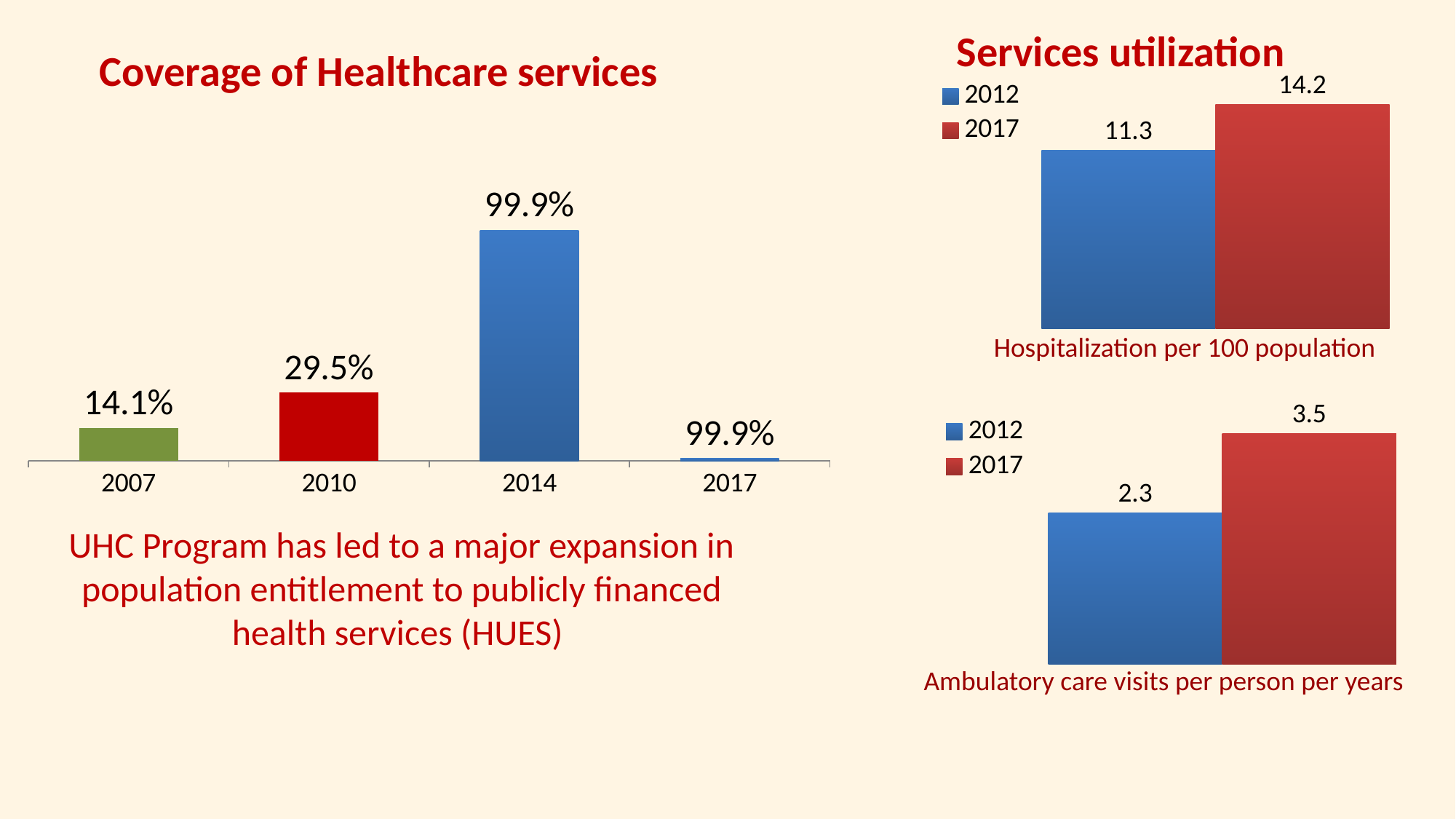
How many years are shown on the x axis of the Coverage of Healthcare services chart? 4 What kind of chart is the Coverage of Healthcare services chart? bar chart In the Ambulatory care visits per person per years chart, which year has the larger value, 2012 or 2017? 2017 In the Coverage of Healthcare services chart, what is the value labelled for 2014? 99.9% In the Ambulatory care visits per person per years chart, what is the value for 2012? 2.3 In the Coverage of Healthcare services chart, what is the value for 2010? 29.5% In the Coverage of Healthcare services chart, what is the value for 2007? 14.1% In the Coverage of Healthcare services chart, which year has the lowest value? 2007 In the Coverage of Healthcare services chart, what is the difference between the 2010 and 2007 values? 15.4% In the Hospitalization per 100 population chart, what is the value for 2017? 14.2 In the Hospitalization per 100 population chart, what is the difference between the 2017 and 2012 values? 2.9 How many series does the legend of the Hospitalization per 100 population chart list? 2